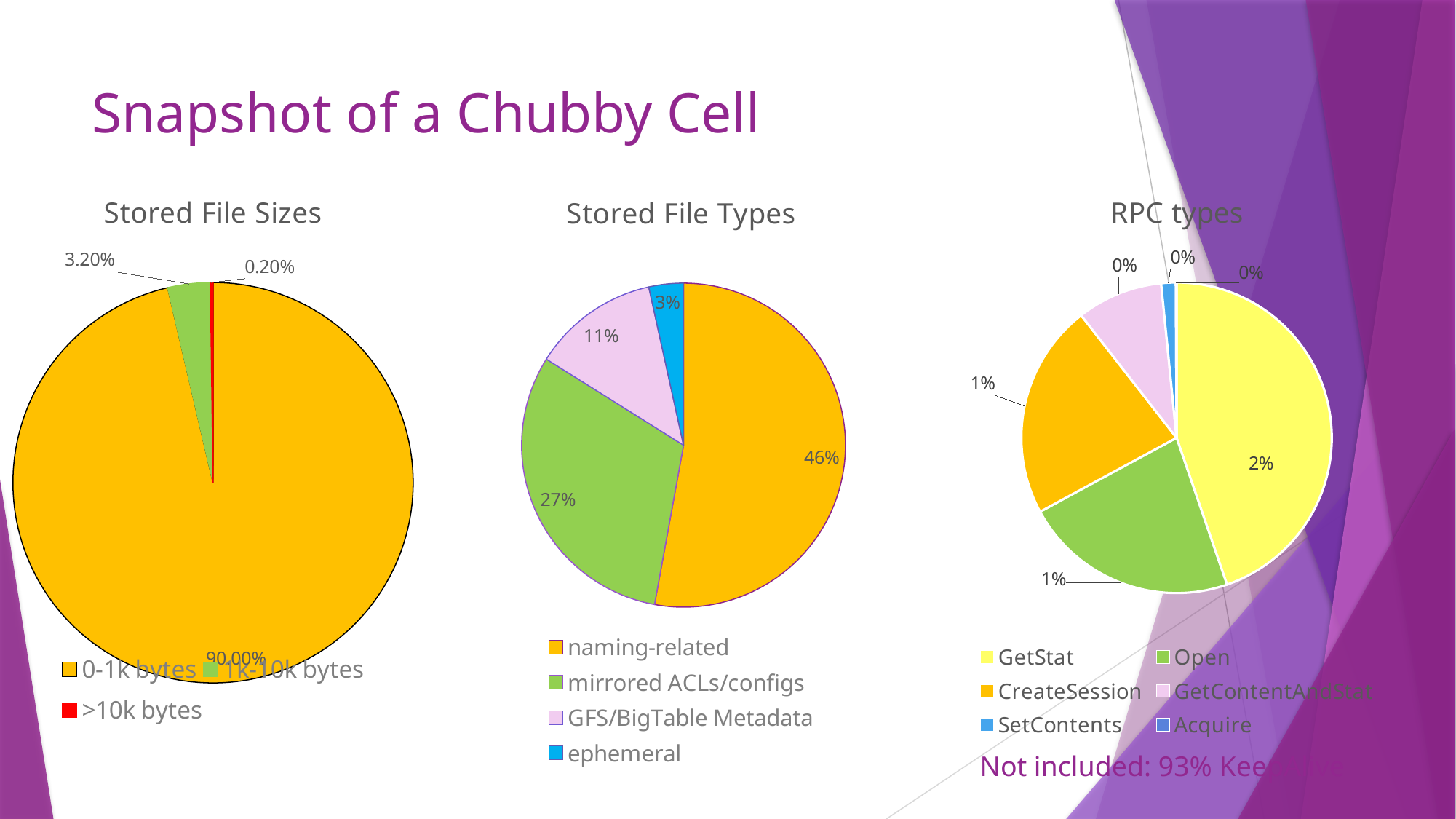
How many categories does the Stored File Types chart show? 4 In the Stored File Sizes chart, what percentage is shown for >10k bytes? 0.20% In the Stored File Sizes chart, what percentage is shown for 1k-10k bytes? 3.20% In the Stored File Types chart, what percentage is mirrored ACLs/configs? 27% In the RPC types chart, what percentage label is shown for GetStat? 2% In the Stored File Types chart, what is the difference between the naming-related and mirrored ACLs/configs percentages? 19% How many entries does the legend of the RPC types chart list? 6 In the Stored File Types chart, what percentage is naming-related? 46% In the Stored File Types chart, which category has the smallest slice? ephemeral In the Stored File Types chart, which is larger: GFS/BigTable Metadata or ephemeral? GFS/BigTable Metadata In the Stored File Sizes chart, which category has the largest slice? 0-1k bytes What kind of chart is the Stored File Sizes chart? pie chart